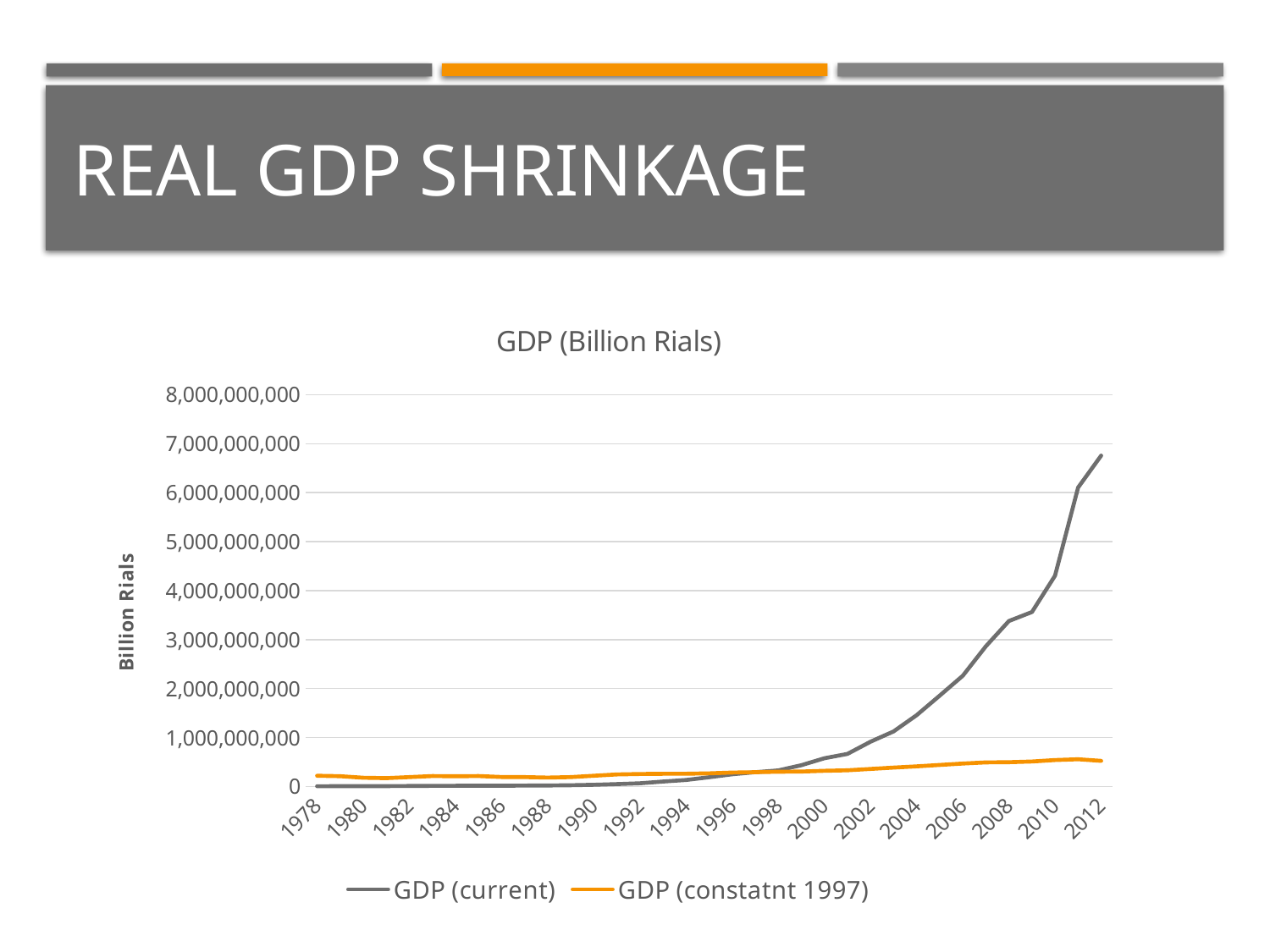
How many series does the legend list? 2 Is the value of GDP (constatnt 1997) in 2012 greater or less than 1,000,000,000? less Is the value of GDP (current) in 2012 greater or less than 6,000,000,000? greater Does the GDP (current) series rise or fall from 1978 to 2012? rise What kind of chart is shown on the slide? line chart Is the value of GDP (current) in 2008 greater or less than 3,000,000,000? greater In which year does the GDP (current) series reach its highest value? 2012 What is the title of the chart? GDP (Billion Rials) In 1980, which series has the higher value, GDP (current) or GDP (constatnt 1997)? GDP (constatnt 1997) What is the label on the vertical axis? Billion Rials In 2012, which series has the higher value, GDP (current) or GDP (constatnt 1997)? GDP (current)